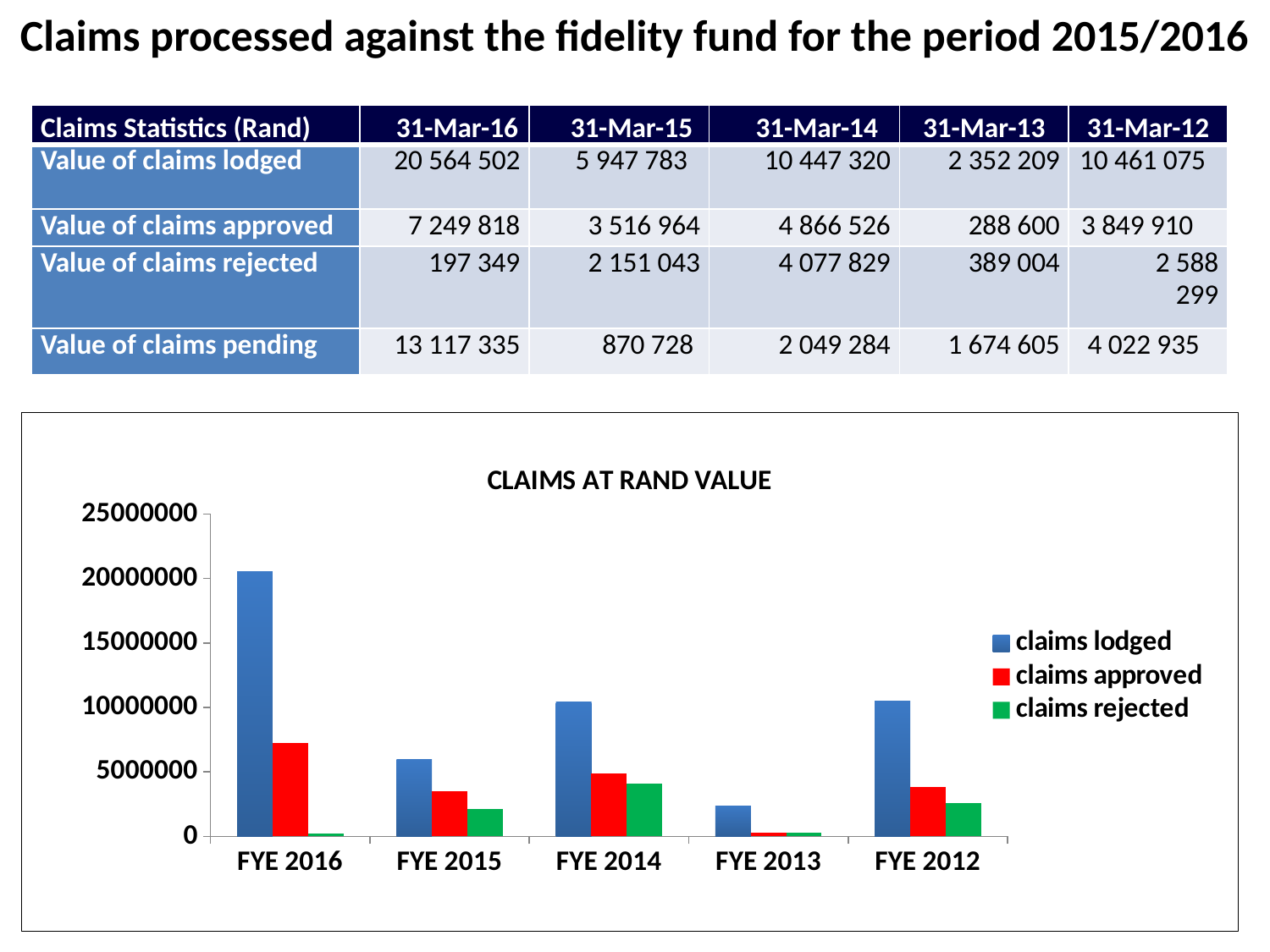
Which fiscal year has the highest value for claims rejected? FYE 2014 How many fiscal year categories are shown on the chart's x axis? 5 What is the title of the chart? CLAIMS AT RAND VALUE Which is larger, claims approved in FYE 2014 or claims approved in FYE 2012? FYE 2014 Which colour represents claims approved in the chart's legend? red Which fiscal year has the lowest value for claims lodged? FYE 2013 How many series does the chart's legend list? 3 Is the value for claims rejected in FYE 2015 greater or less than 5000000? less Is the value for claims lodged in FYE 2016 greater or less than 15000000? greater Which fiscal year has the lowest value for claims approved? FYE 2013 Which fiscal year has the highest value for claims lodged? FYE 2016 What kind of chart is shown on the slide? bar chart